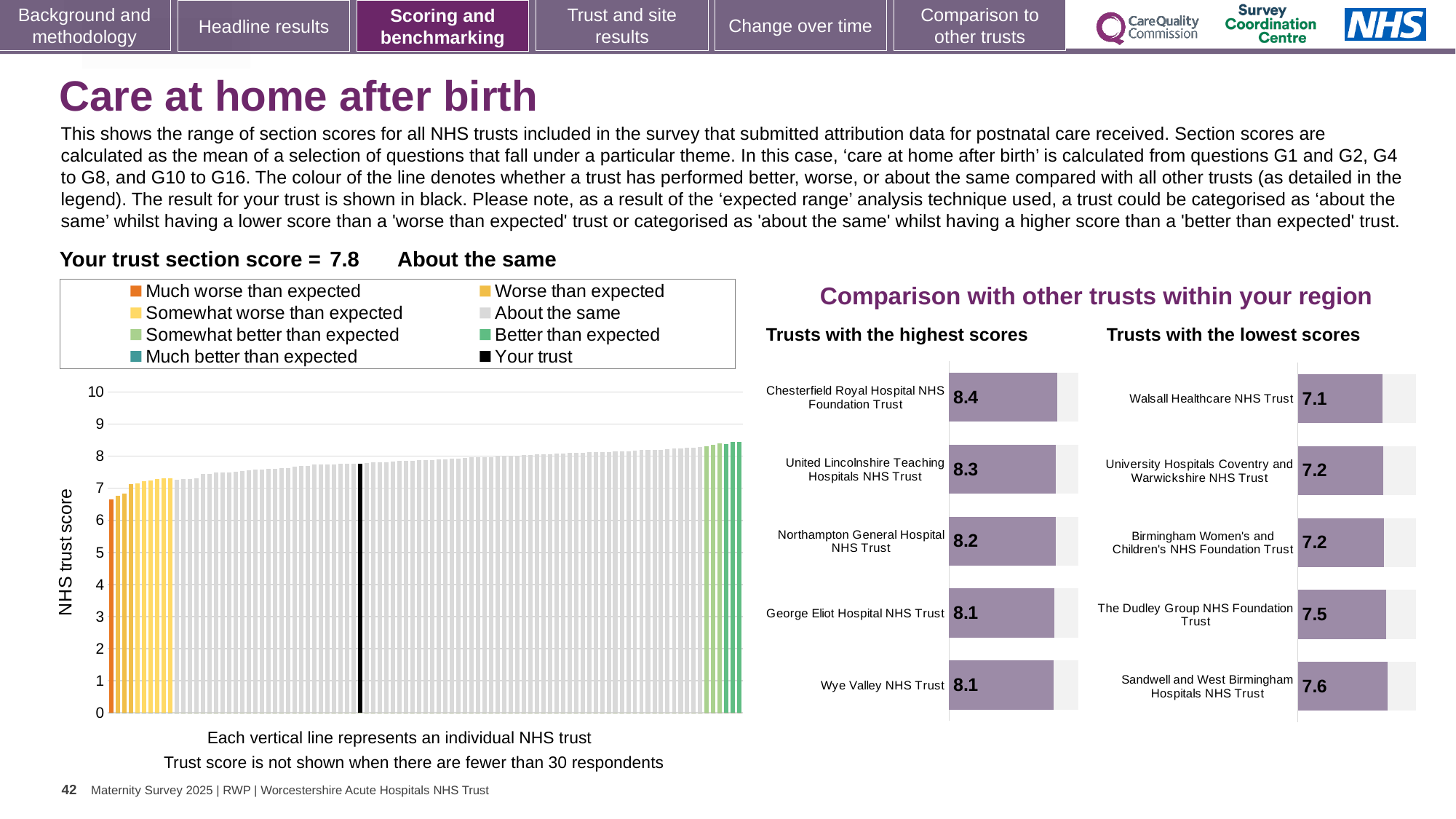
On the 'Trusts with the lowest scores' chart, what is the difference between the scores for Sandwell and West Birmingham Hospitals NHS Trust and Walsall Healthcare NHS Trust? 0.5 On the 'Trusts with the highest scores' chart, which trust has the highest score? Chesterfield Royal Hospital NHS Foundation Trust What is the difference between the score for Chesterfield Royal Hospital NHS Foundation Trust on the 'Trusts with the highest scores' chart and the score for Walsall Healthcare NHS Trust on the 'Trusts with the lowest scores' chart? 1.3 On the 'Trusts with the lowest scores' chart, what is the score for Walsall Healthcare NHS Trust? 7.1 On the main chart on the left, what is the section score for your trust (the black bar)? 7.8 On the 'Trusts with the highest scores' chart, which has the larger score: Northampton General Hospital NHS Trust or Wye Valley NHS Trust? Northampton General Hospital NHS Trust On the 'Trusts with the lowest scores' chart, what is the score for The Dudley Group NHS Foundation Trust? 7.5 On the main chart on the left, is the value of the lowest bar greater or less than 7? less On the 'Trusts with the lowest scores' chart, which trust has the lowest score? Walsall Healthcare NHS Trust On the 'Trusts with the highest scores' chart, what is the score for Chesterfield Royal Hospital NHS Foundation Trust? 8.4 How many trusts are shown on the 'Trusts with the lowest scores' chart? 5 How many entries does the legend of the main chart on the left list? 8